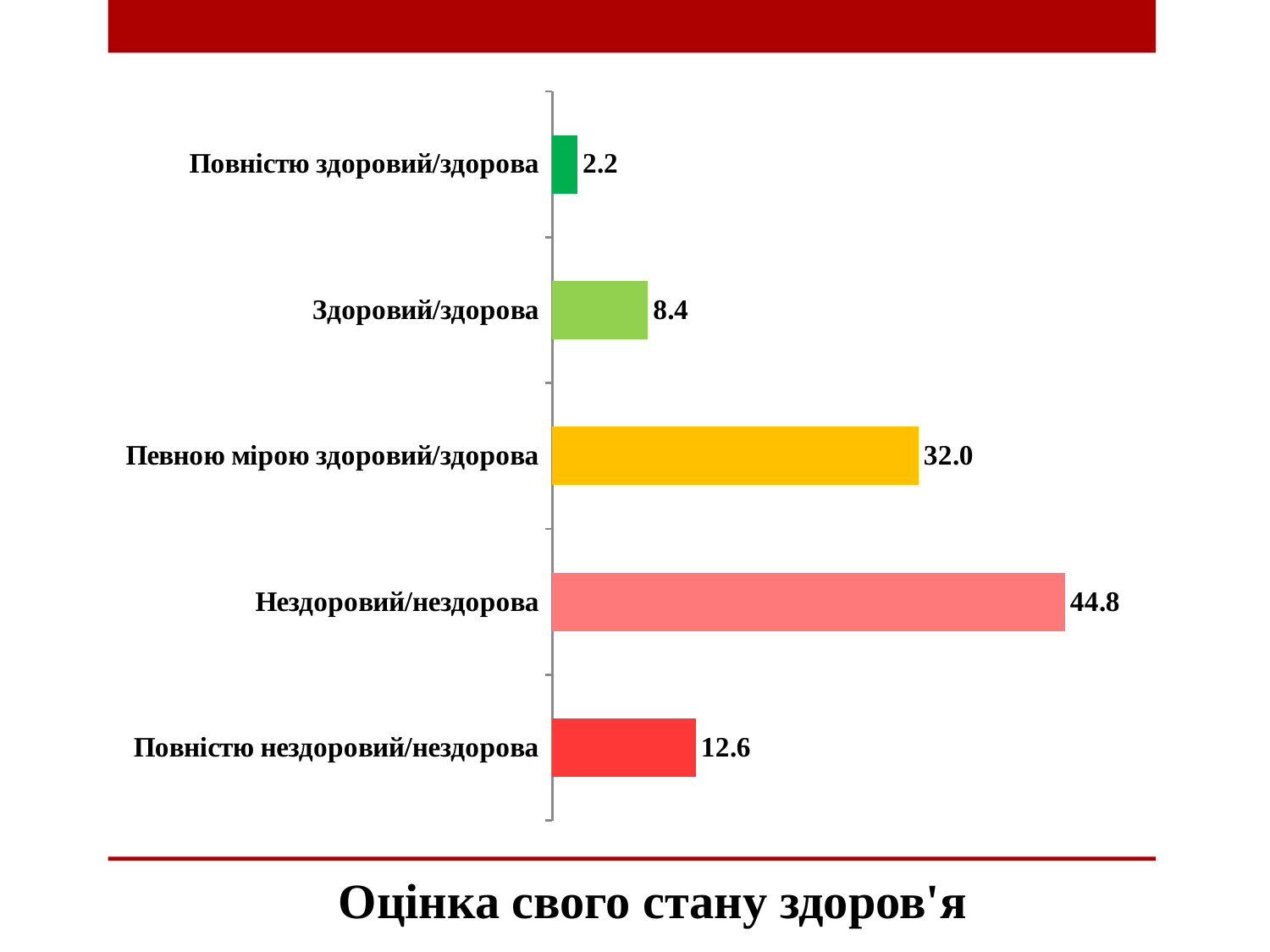
What is the value for Певною мірою здоровий/здорова? 32.0 What is the value for Нездоровий/нездорова? 44.8 What is the value for Повністю нездоровий/нездорова? 12.6 What is the difference between the values for Повністю нездоровий/нездорова and Здоровий/здорова? 4.2 What is the difference between the values for Нездоровий/нездорова and Певною мірою здоровий/здорова? 12.8 Which is larger, the value for Здоровий/здорова or the value for Повністю нездоровий/нездорова? Повністю нездоровий/нездорова Which category has the lowest value? Повністю здоровий/здорова How many categories are shown in the chart? 5 What is the value for Повністю здоровий/здорова? 2.2 Which category has the highest value? Нездоровий/нездорова What kind of chart is shown on the slide? Bar chart What is the title shown below the chart? Оцінка свого стану здоров'я